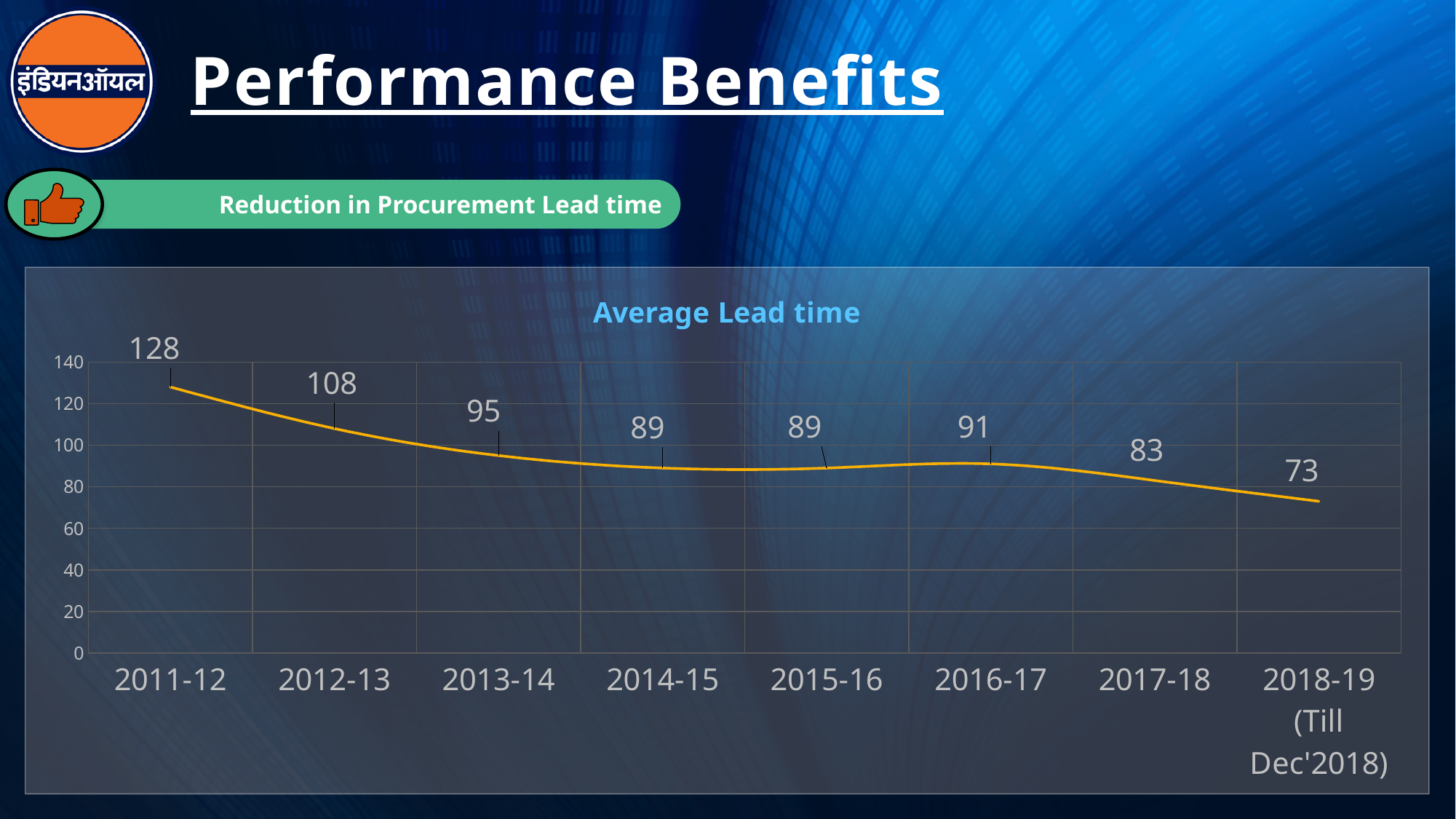
By how much did the average lead time fall from 2011-12 to 2018-19 (Till Dec'2018)? 55 Which period has the highest average lead time? 2011-12 What is the average lead time for 2016-17? 91 Which period has the lowest average lead time? 2018-19 (Till Dec'2018) Which is larger, the average lead time for 2013-14 or for 2017-18? 2013-14 What is the average lead time for 2011-12? 128 How many periods are plotted on the x axis? 8 What kind of chart is shown? Line chart What is the title of the chart? Average Lead time What is the average lead time for 2018-19 (Till Dec'2018)? 73 Does the average lead time generally rise or fall from 2011-12 to 2018-19? Fall What is the difference in average lead time between 2011-12 and 2012-13? 20